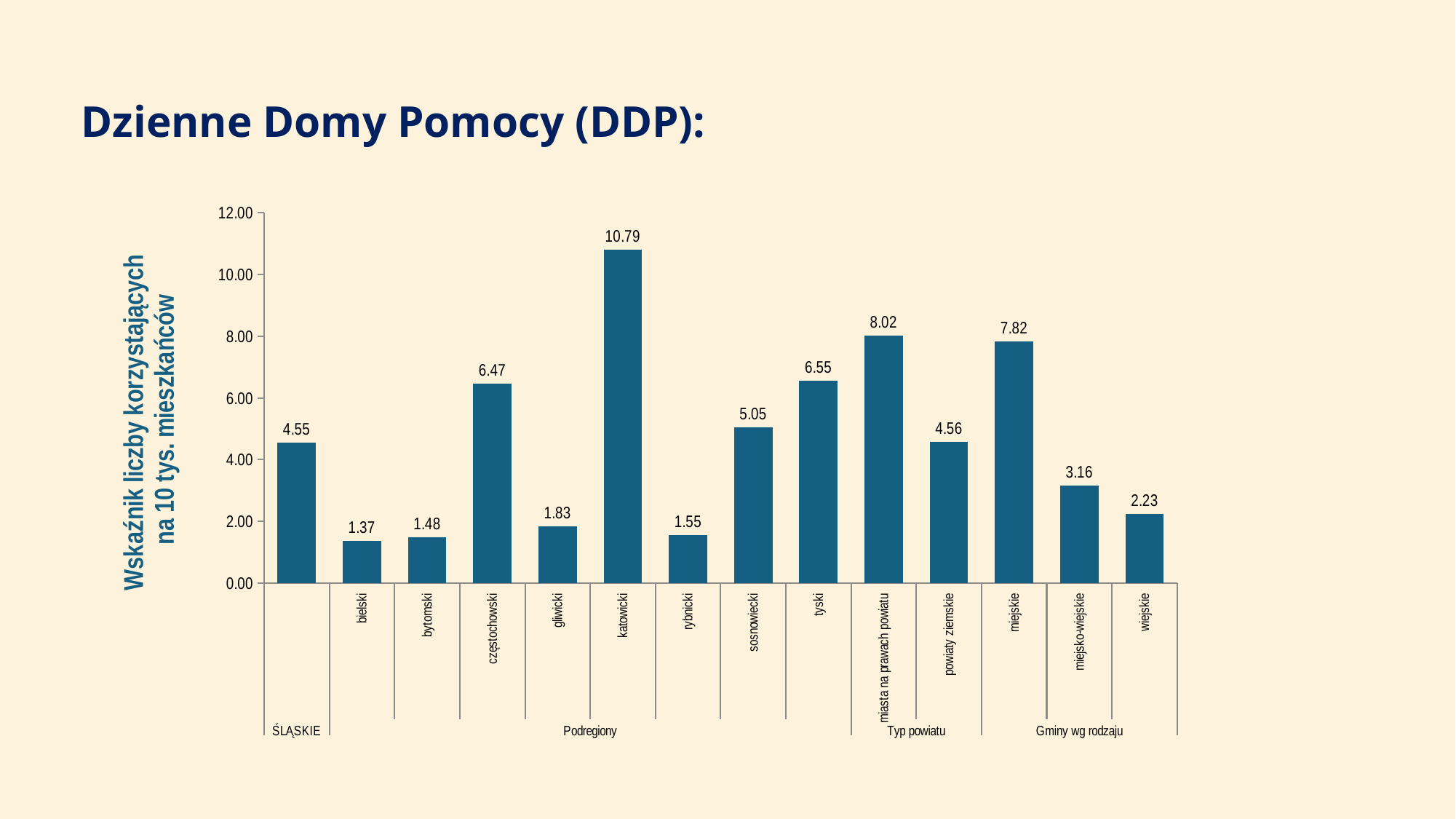
Which category has the highest value? katowicki What is the value for ŚLĄSKIE? 4.55 What is the value for miejsko-wiejskie? 3.16 What is the value for katowicki? 10.79 Which is larger, the value for tyski or the value for częstochowski? tyski Which category has the lowest value? bielski What is the difference between the values for miejskie and wiejskie? 5.59 What is the difference between the values for miasta na prawach powiatu and powiaty ziemskie? 3.46 What is the label of the vertical axis? Wskaźnik liczby korzystających na 10 tys. mieszkańców Is the value for miejskie greater or less than 6.00? greater How many bars are shown in the chart? 14 What kind of chart is shown on the slide? bar chart